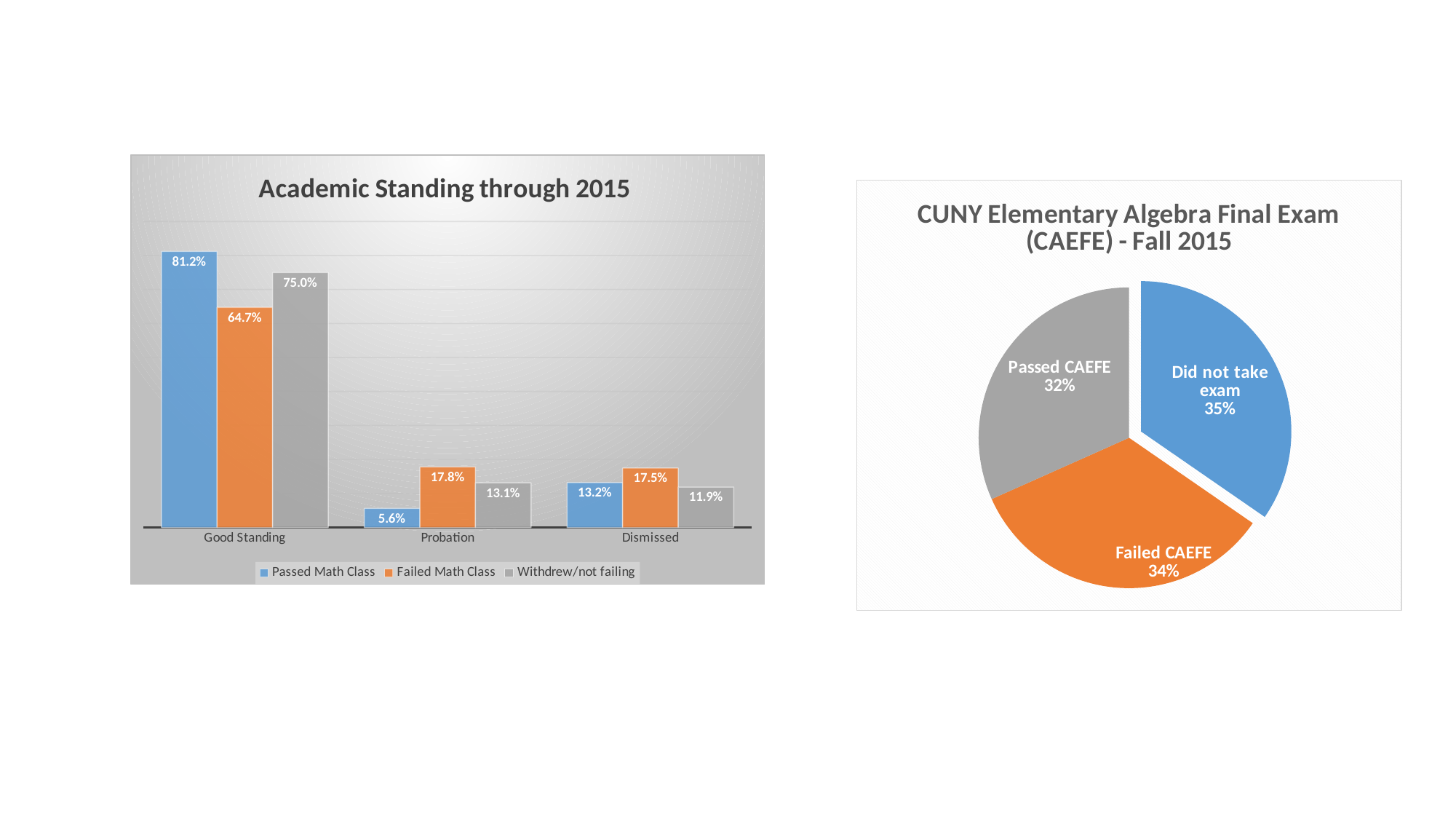
In the 'Academic Standing through 2015' chart, what is the value for Failed Math Class in the Dismissed category? 17.5% In the 'Academic Standing through 2015' chart, which category has the lowest value for Passed Math Class? Probation In the 'CUNY Elementary Algebra Final Exam (CAEFE) - Fall 2015' chart, which slice is the largest? Did not take exam In the 'CUNY Elementary Algebra Final Exam (CAEFE) - Fall 2015' chart, what share of the pie is Failed CAEFE? 34% In the 'Academic Standing through 2015' chart, which is larger in the Dismissed category: Passed Math Class or Withdrew/not failing? Passed Math Class What kind of chart is 'CUNY Elementary Algebra Final Exam (CAEFE) - Fall 2015'? Pie chart In the 'Academic Standing through 2015' chart, what is the difference between Passed Math Class and Failed Math Class in the Good Standing category? 16.5% In the 'Academic Standing through 2015' chart, what is the value for Passed Math Class in the Good Standing category? 81.2% How many series does the legend of the 'Academic Standing through 2015' chart list? 3 In the 'Academic Standing through 2015' chart, what is the value for Withdrew/not failing in the Probation category? 13.1% What kind of chart is 'Academic Standing through 2015'? Bar chart How many categories are shown on the x axis of the 'Academic Standing through 2015' chart? 3